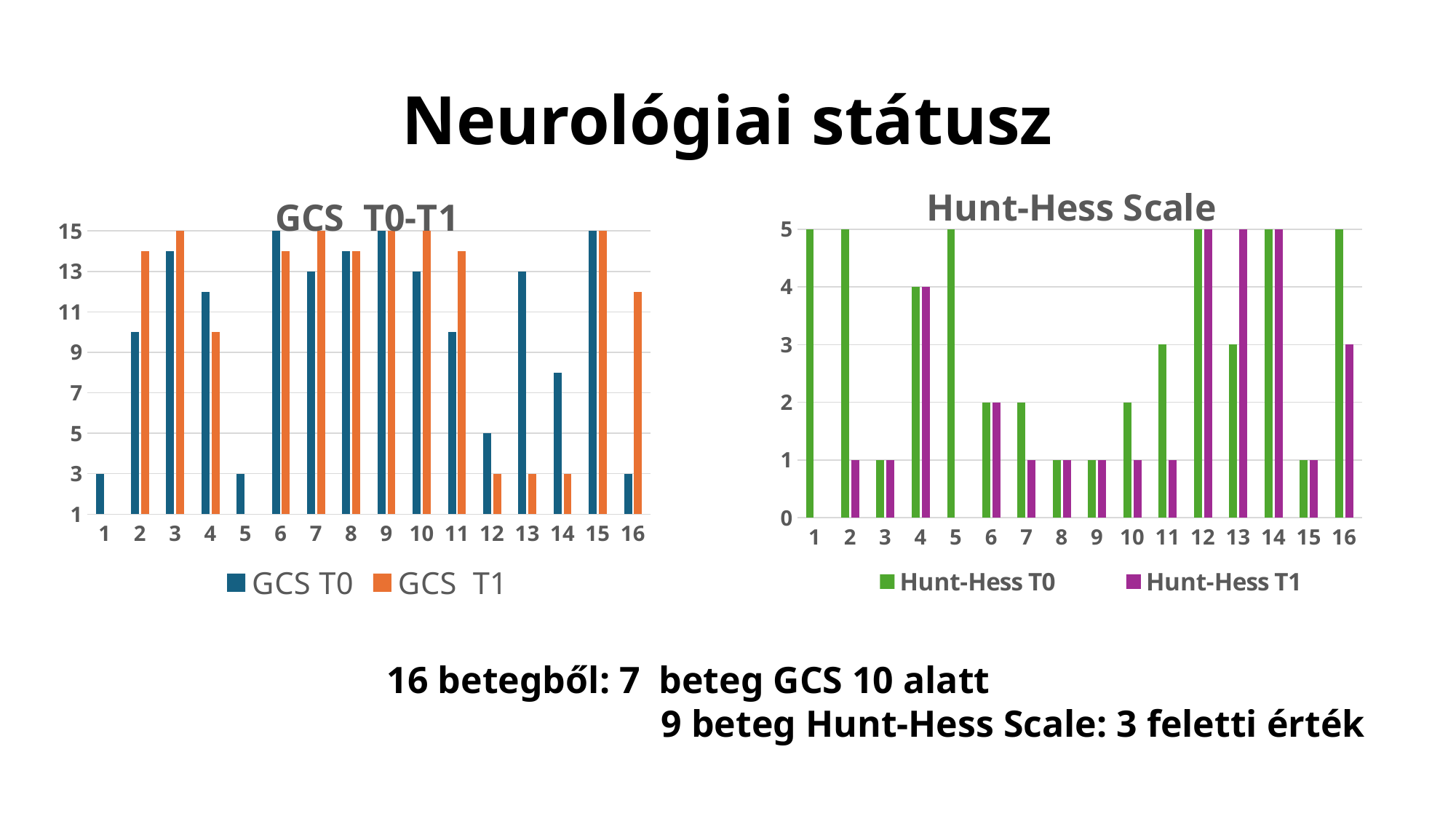
In the "GCS T0-T1" chart, what is the GCS T0 value for patient 15? 15 In the "Hunt-Hess Scale" chart, which is larger for patient 13: Hunt-Hess T0 or Hunt-Hess T1? Hunt-Hess T1 In the "Hunt-Hess Scale" chart, what is the Hunt-Hess T0 value for patient 11? 3 In the "Hunt-Hess Scale" chart, what is the Hunt-Hess T1 value for patient 16? 3 How many series does the legend of the "GCS T0-T1" chart list? 2 In the "GCS T0-T1" chart, what is the GCS T0 value for patient 1? 3 What kind of chart is the "GCS T0-T1" chart on the left? bar chart In the "Hunt-Hess Scale" chart, how many patients (categories) are shown on the x axis? 16 In the "GCS T0-T1" chart, is the GCS T0 value for patient 2 greater or less than 9? greater What are the two legend entries of the "Hunt-Hess Scale" chart? Hunt-Hess T0 and Hunt-Hess T1 In the "GCS T0-T1" chart, what is the GCS T1 value for patient 12? 3 In the "Hunt-Hess Scale" chart, what is the difference between the Hunt-Hess T0 and Hunt-Hess T1 values for patient 16? 2